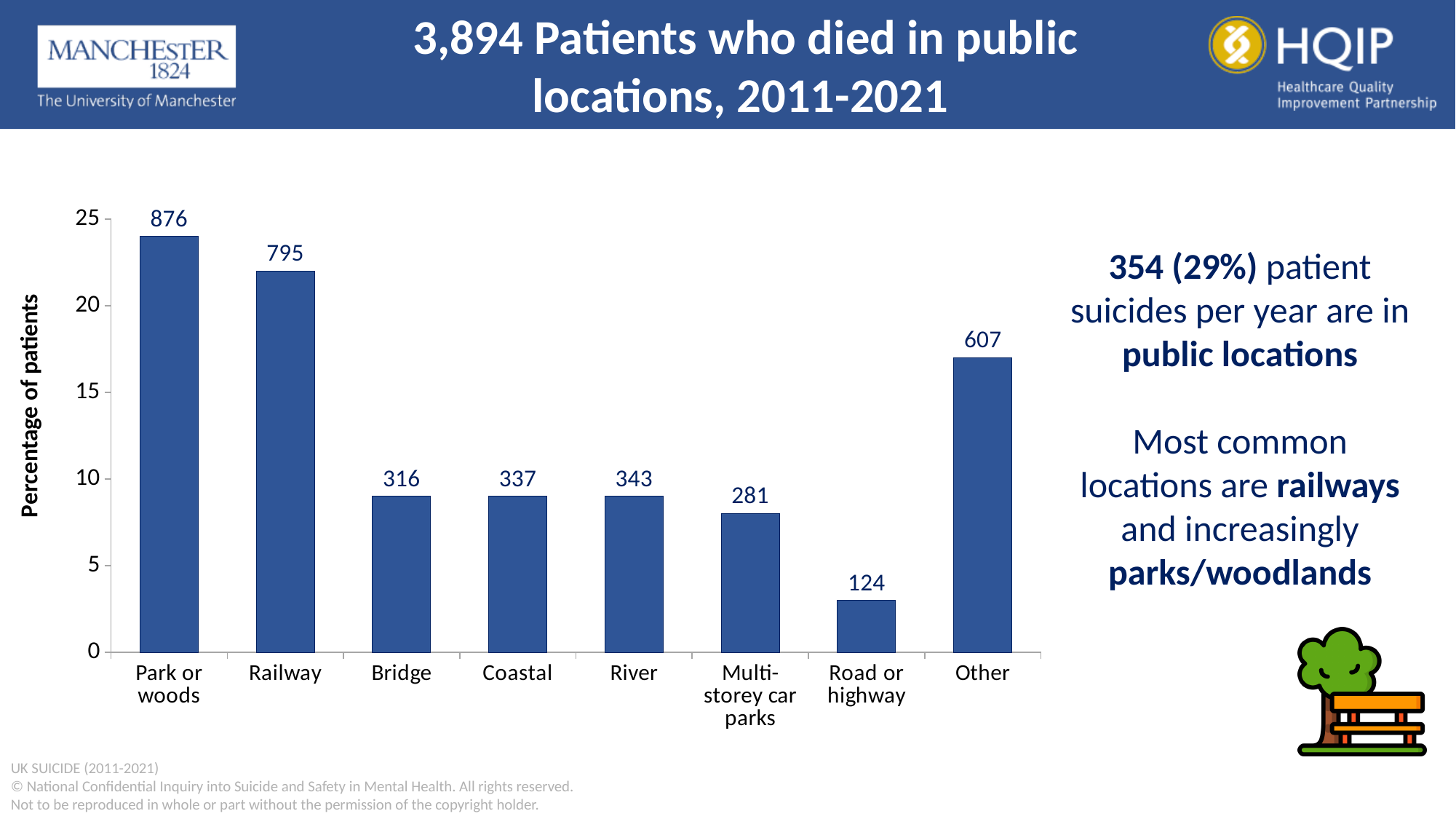
What is the data label shown for the Other bar? 607 Which location category has the lowest bar? Road or highway What kind of chart is shown on the slide? Bar chart What is the difference between the data labels for Park or woods and Railway? 81 Is the percentage of patients for Other greater or less than 15? greater Which location category has the highest bar? Park or woods Is the percentage of patients for Bridge greater or less than 10? less What is the data label shown for the Multi-storey car parks bar? 281 What is the data label shown for the Railway bar? 795 What is the data label shown for the Park or woods bar? 876 Which has the larger data label, Coastal or River? River How many location categories are shown on the x axis? 8